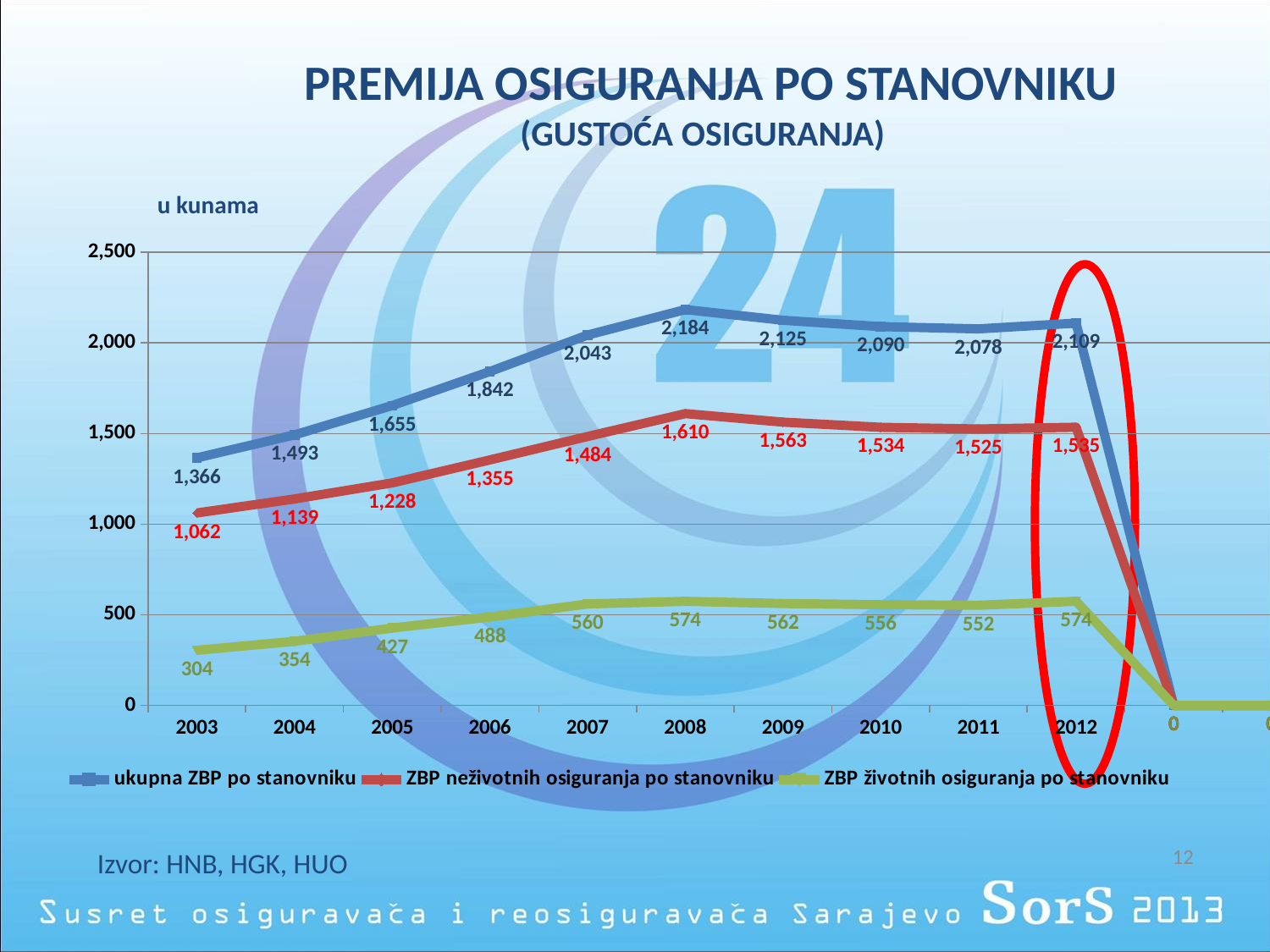
What is the value of ZBP životnih osiguranja po stanovniku in 2005? 427 What is the difference between ukupna ZBP po stanovniku in 2008 and in 2003? 818 In which year is ukupna ZBP po stanovniku highest? 2008 Is the value of ZBP životnih osiguranja po stanovniku in 2008 greater or less than 500? greater What type of chart is shown on the slide? line chart What unit is stated above the chart? u kunama How many series does the legend list? 3 What is the value of ukupna ZBP po stanovniku in 2008? 2,184 Does ukupna ZBP po stanovniku rise or fall from 2003 to 2008? rise In which year is ZBP životnih osiguranja po stanovniku lowest? 2003 Which is larger: ZBP neživotnih osiguranja po stanovniku in 2008 or in 2009? 2008 What is the value of ZBP neživotnih osiguranja po stanovniku in 2003? 1,062